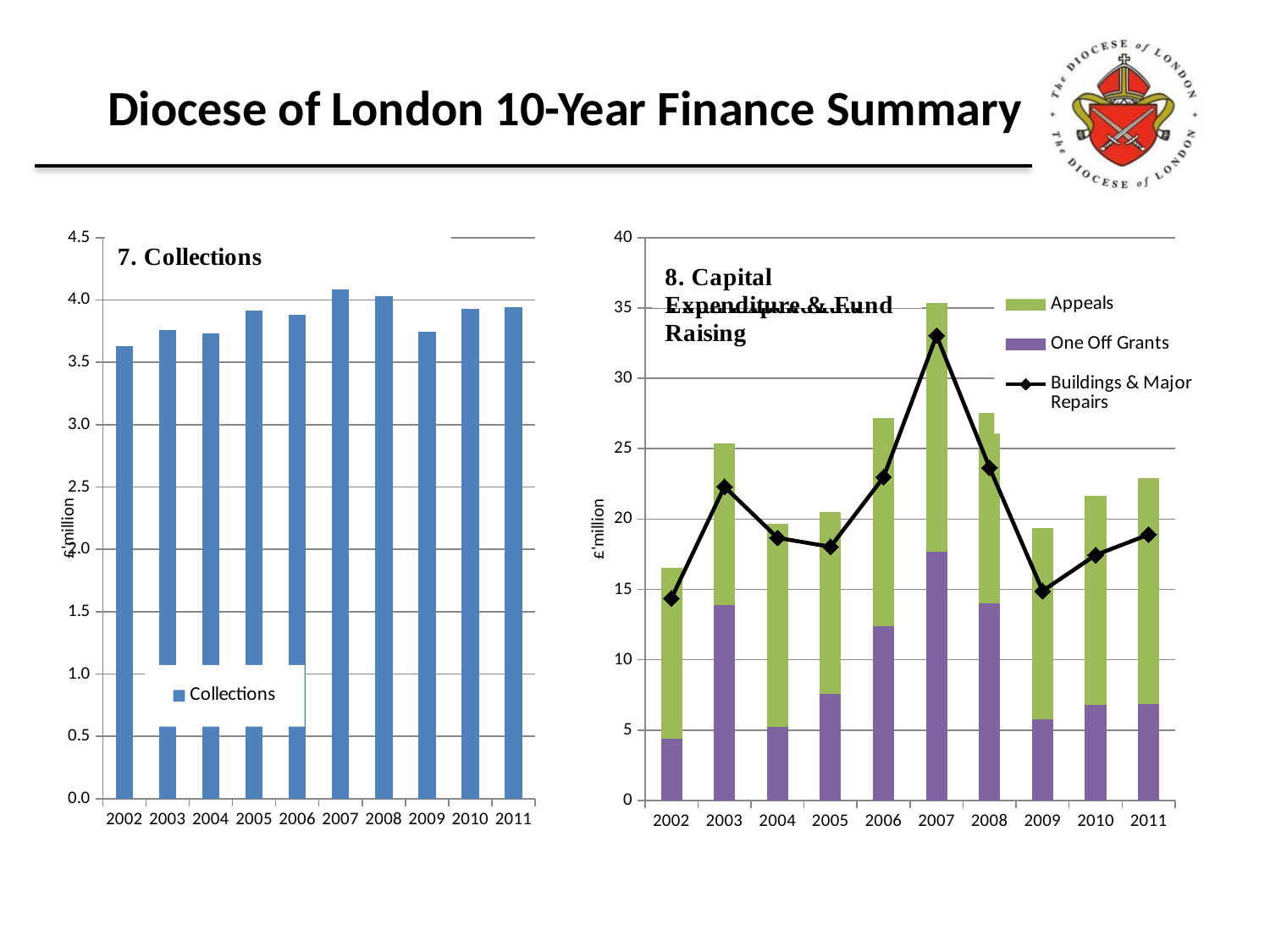
In the "8. Capital Expenditure & Fund Raising" chart, is the Buildings & Major Repairs value for 2007 greater or less than 30? greater In the "7. Collections" chart, is the value for 2007 greater or less than 4.0? greater In the "8. Capital Expenditure & Fund Raising" chart, is the One Off Grants value for 2003 larger or smaller than the One Off Grants value for 2004? larger In the "8. Capital Expenditure & Fund Raising" chart, in which year does the Buildings & Major Repairs line reach its highest value? 2007 In the "7. Collections" chart, how many years are shown on the x axis? 10 In the "8. Capital Expenditure & Fund Raising" chart, how many series does the legend list? 3 In the "7. Collections" chart, is the value for 2009 greater or less than 4.0? less What kind of chart is "7. Collections"? Bar chart In the "7. Collections" chart, which year has the highest collections? 2007 In the "8. Capital Expenditure & Fund Raising" chart, which year has the lowest total stacked bar? 2002 In the "7. Collections" chart, which year has the lowest collections? 2002 In the "8. Capital Expenditure & Fund Raising" chart, which series is shown as a line with diamond markers? Buildings & Major Repairs